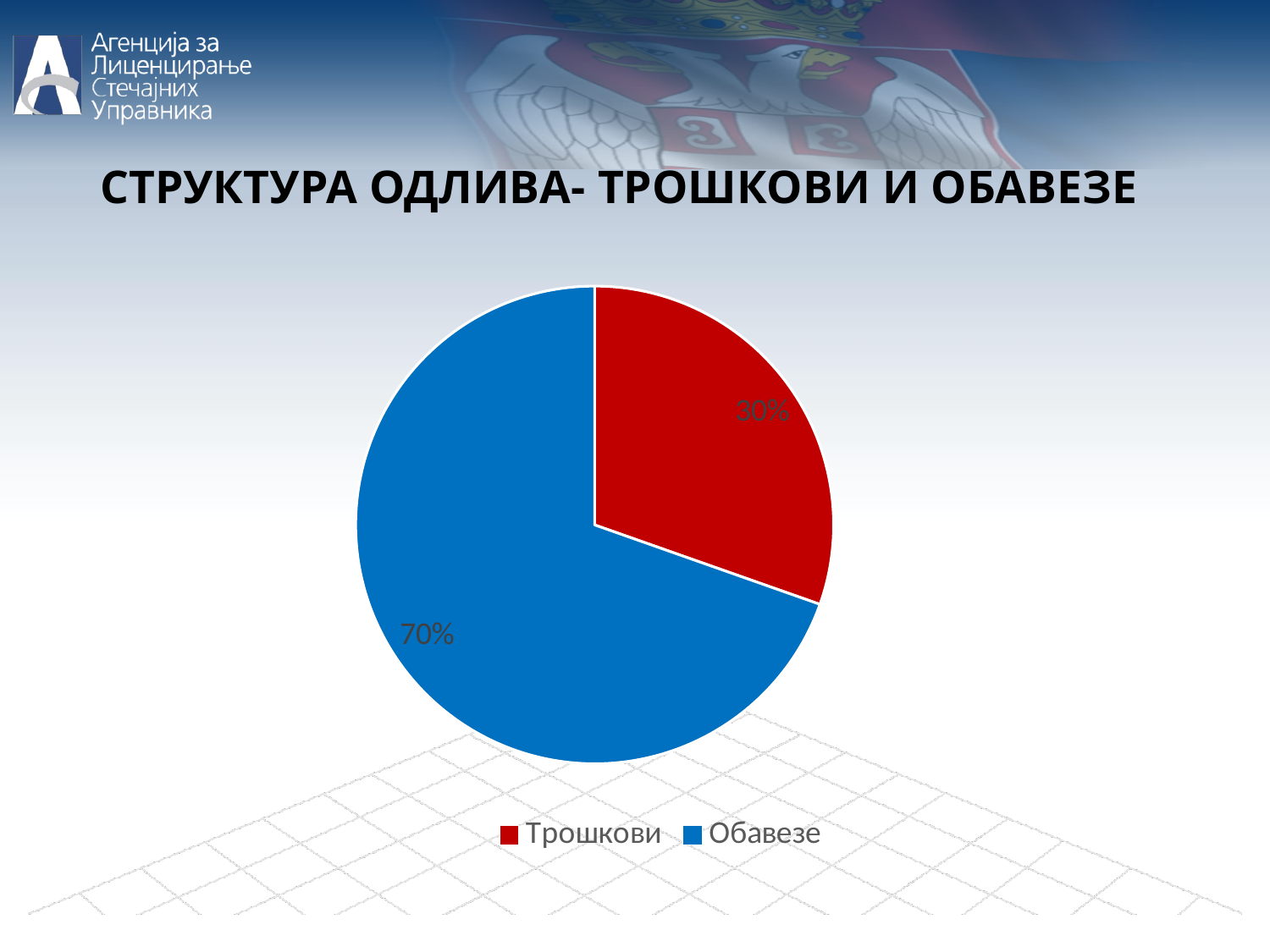
What is the title of the slide above the chart? СТРУКТУРА ОДЛИВА- ТРОШКОВИ И ОБАВЕЗЕ Which category has the smallest slice of the pie? Трошкови Which category has the largest slice of the pie? Обавезе What is the difference in percentage points between the Обавезе and Трошкови slices? 40 How many slices does the pie chart have? 2 What share of the pie does Трошкови represent? 30% What kind of chart is shown on the slide? pie chart How many entries does the legend list? 2 What colour is the Трошкови slice? red Which is larger, the slice for Трошкови or the slice for Обавезе? Обавезе What share of the pie does Обавезе represent? 70%